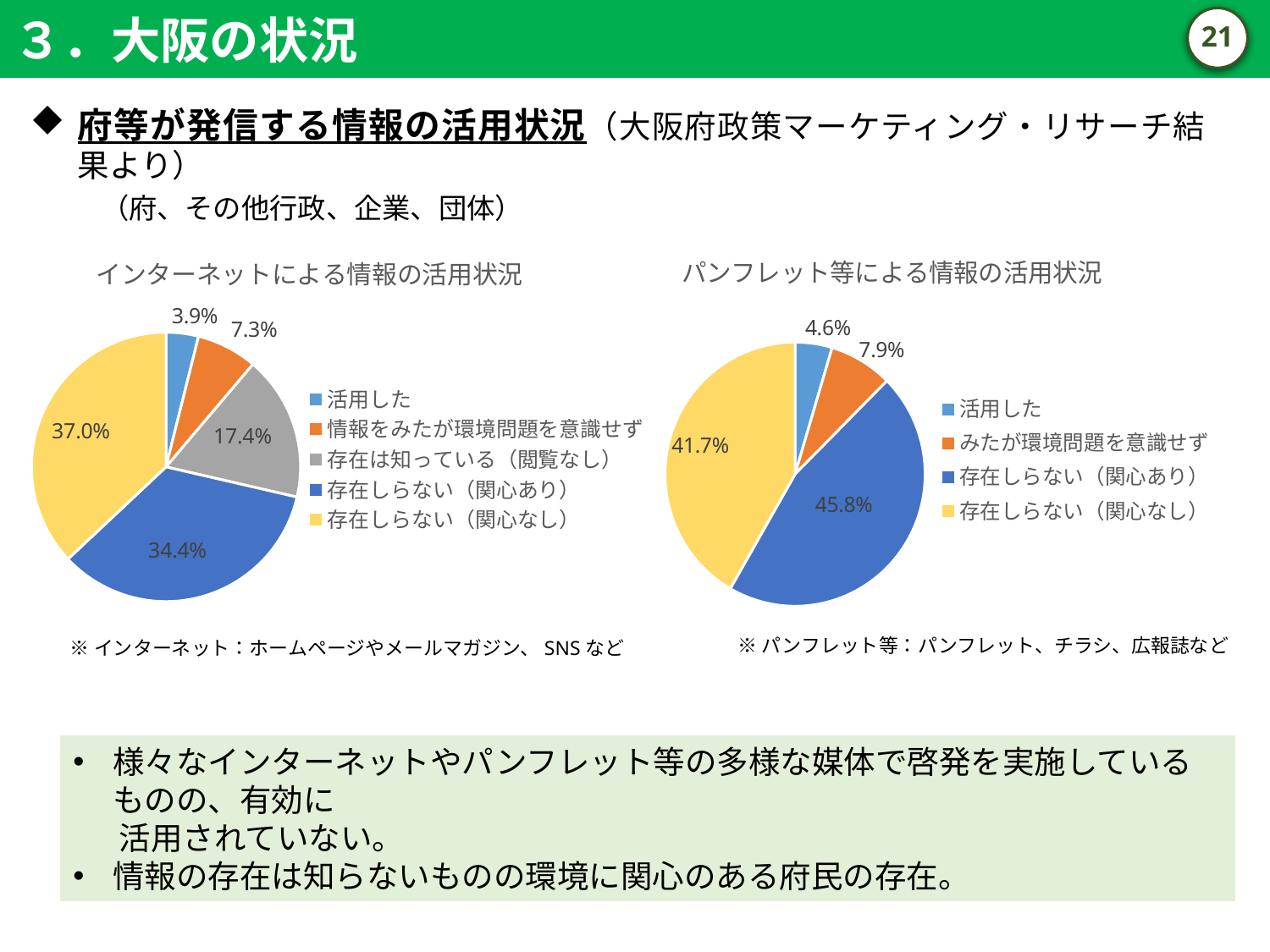
In the chart titled インターネットによる情報の活用状況, what colour is the slice for 存在しらない（関心あり）? Blue How many categories does the chart titled パンフレット等による情報の活用状況 show? 4 In the chart titled インターネットによる情報の活用状況, what is the difference between 存在しらない（関心なし） and 存在しらない（関心あり）? 2.6% In the chart titled インターネットによる情報の活用状況, what is the value for 活用した? 3.9% In the chart titled パンフレット等による情報の活用状況, which is larger: 存在しらない（関心あり） or 存在しらない（関心なし）? 存在しらない（関心あり） In the chart titled インターネットによる情報の活用状況, what is the value for 存在は知っている（閲覧なし）? 17.4% In the chart titled パンフレット等による情報の活用状況, which category has the smallest share? 活用した How many categories does the chart titled インターネットによる情報の活用状況 show? 5 In the chart titled インターネットによる情報の活用状況, which category has the largest share? 存在しらない（関心なし） In the chart titled パンフレット等による情報の活用状況, what is the value for みたが環境問題を意識せず? 7.9% In the chart titled パンフレット等による情報の活用状況, what is the value for 存在しらない（関心あり）? 45.8% What kind of chart is the chart titled パンフレット等による情報の活用状況? Pie chart